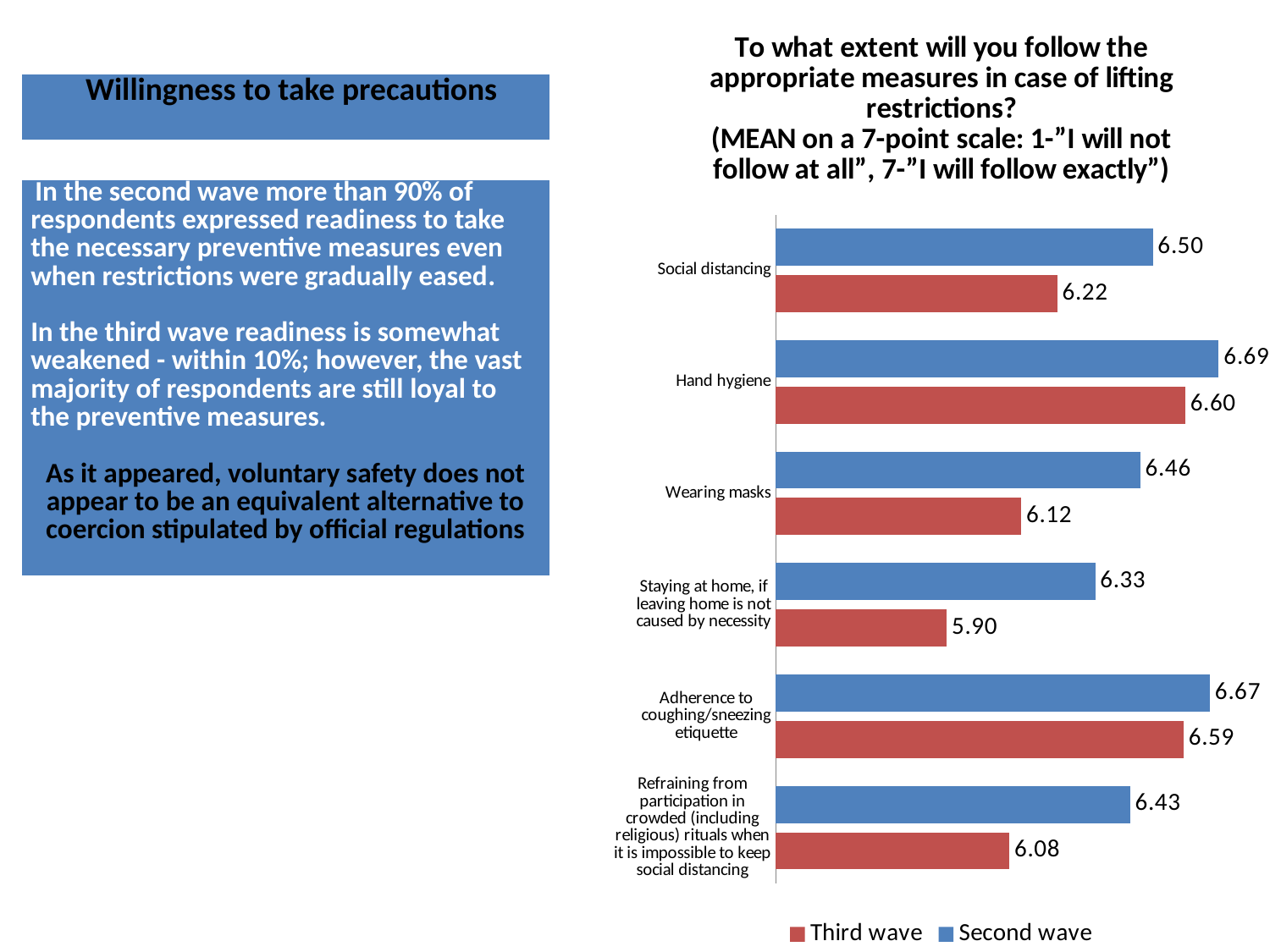
What is the difference between the Second wave and Third wave values for Wearing masks? 0.34 What is the Third wave value for Staying at home, if leaving home is not caused by necessity? 5.90 What is the Second wave value for Social distancing? 6.50 What kind of chart is shown on the slide? Bar chart Which is larger: the Third wave value for Social distancing or the Third wave value for Refraining from participation in crowded rituals? Social distancing Which category has the lowest Third wave value? Staying at home, if leaving home is not caused by necessity What is the Third wave value for Wearing masks? 6.12 What is the Second wave value for Adherence to coughing/sneezing etiquette? 6.67 Which category has the highest Second wave value? Hand hygiene How many categories are shown in the chart? 6 How many series does the legend list? 2 What is the difference between the Second wave and Third wave values for Hand hygiene? 0.09